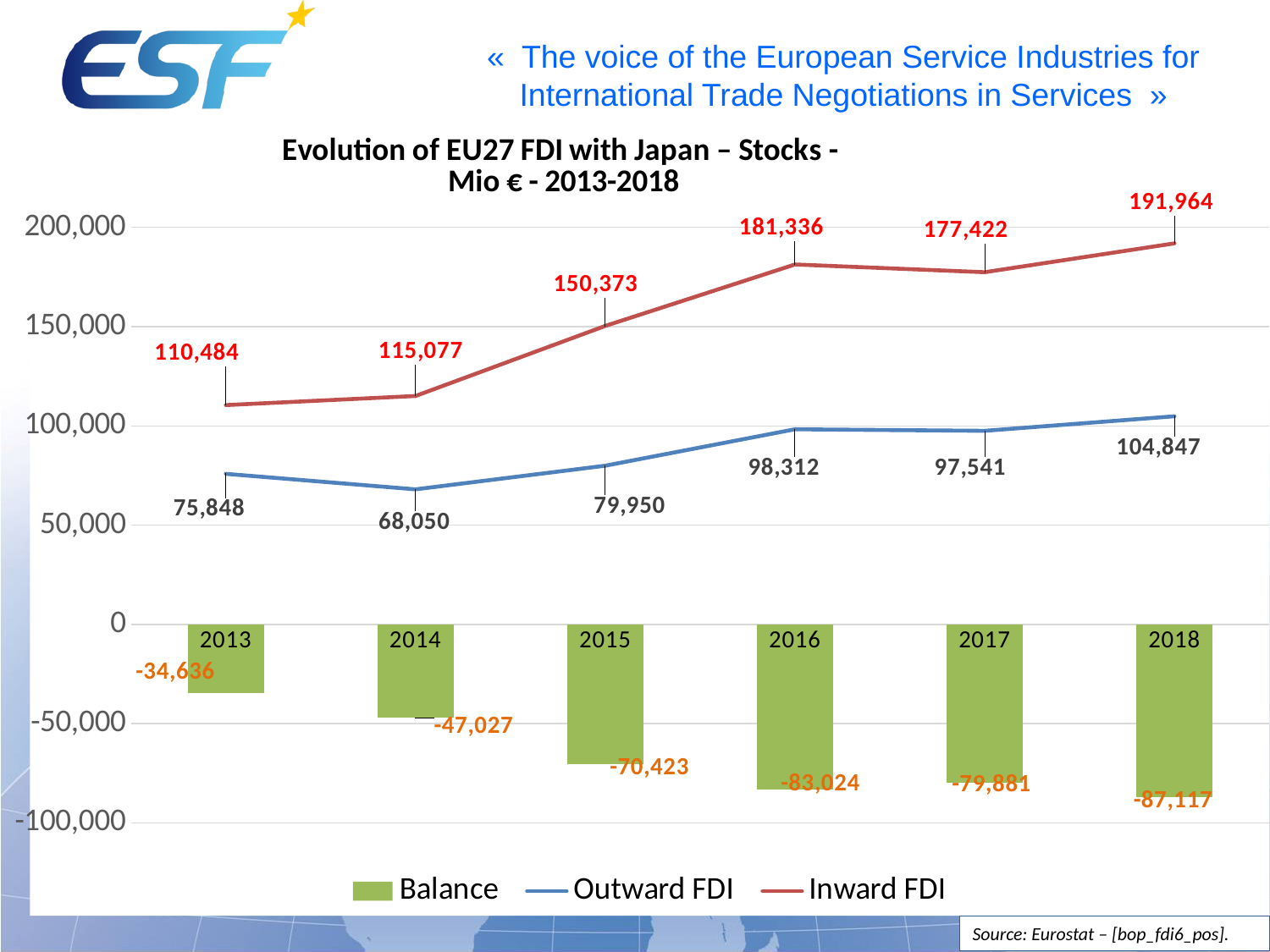
What is the Inward FDI value for 2016? 181,336 What is the difference between Inward FDI and Outward FDI in 2013? 34,636 Which is larger in 2017: Inward FDI or Outward FDI? Inward FDI In which year is Inward FDI highest? 2018 In which year is Outward FDI lowest? 2014 How many series does the legend list? 3 What is the Outward FDI value for 2014? 68,050 What is the Balance value for 2018? -87,117 Does Inward FDI rise or fall from 2013 to 2018 overall? rise How many years are shown on the x axis? 6 Is the Inward FDI value for 2015 greater or less than 150,000? greater Which series is shown as green bars? Balance